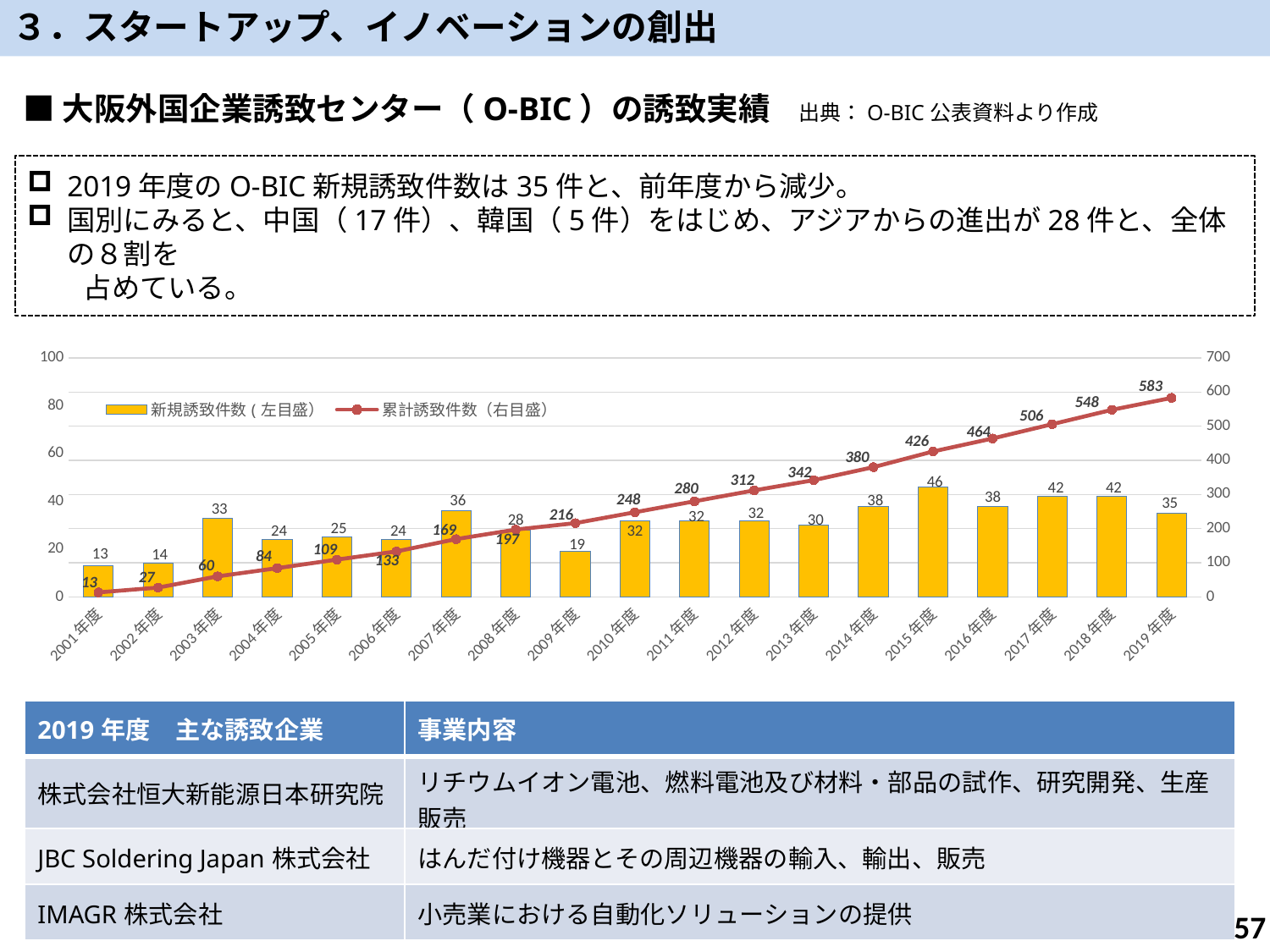
Which year has the highest 新規誘致件数? 2015年度 What is the value of 新規誘致件数 for 2019年度? 35 Does the 累計誘致件数 line rise or fall from 2001年度 to 2019年度? Rise What kind of chart is this? Combined bar and line chart What is the value of 累計誘致件数 for 2010年度? 248 What is the value of 新規誘致件数 for 2007年度? 36 How many series does the legend list? 2 Which year has the lowest 新規誘致件数? 2001年度 What is the value of 累計誘致件数 for 2019年度? 583 What is the difference in 新規誘致件数 between 2018年度 and 2019年度? 7 How many fiscal years are shown on the x axis? 19 Which is larger, the 新規誘致件数 for 2003年度 or for 2009年度? 2003年度